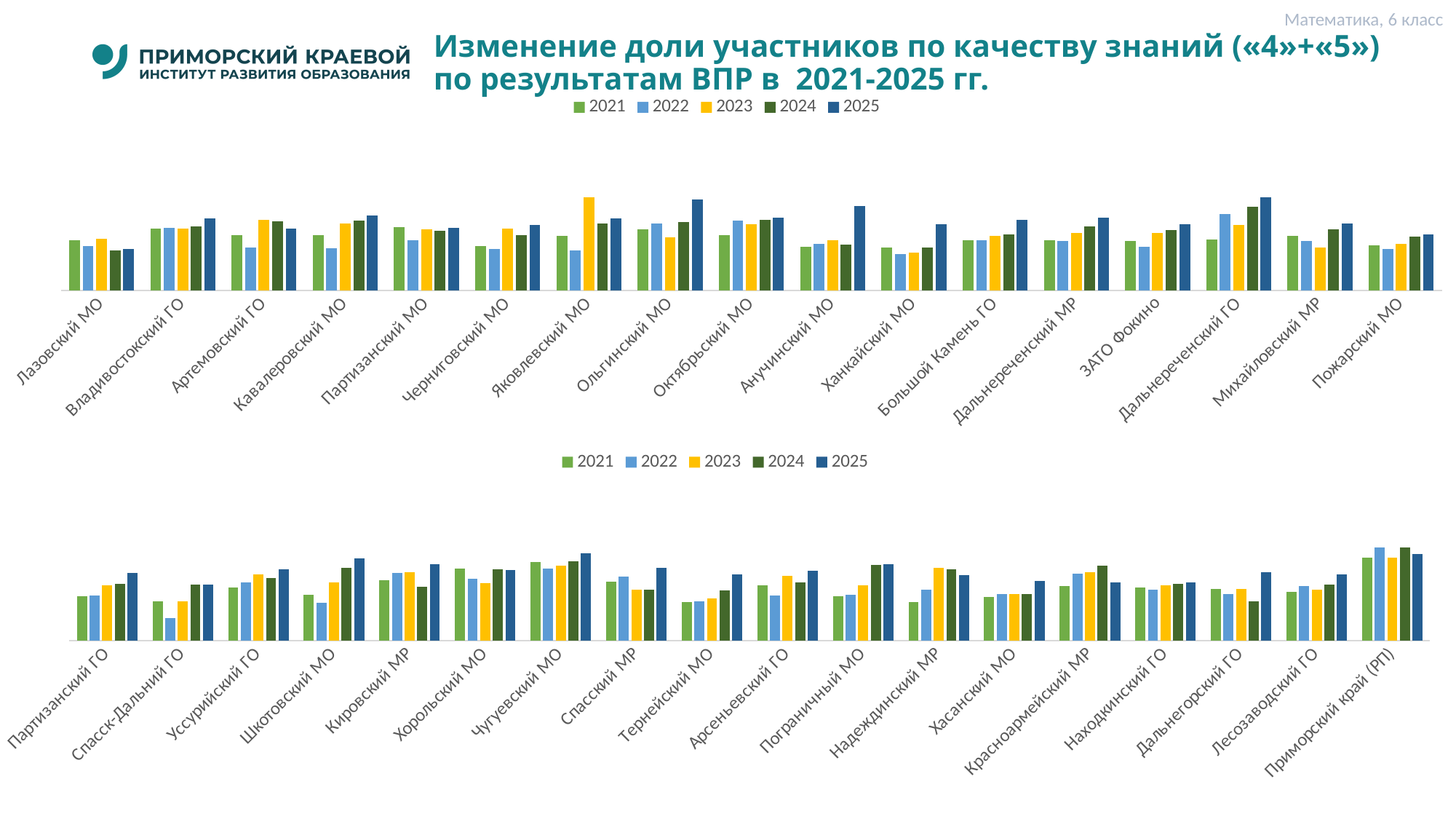
How many categories (municipalities) are shown on the top chart? 17 On the bottom chart, which year has the lowest bar for Спасск-Дальний ГО? 2022 What colour represents the 2023 series in the charts? Yellow What kind of chart is used on this slide? Bar chart Which years are listed in the legend of the charts? 2021, 2022, 2023, 2024, 2025 How many categories are shown on the bottom chart? 18 On the bottom chart, for Приморский край (РП), which is larger: the 2022 value or the 2023 value? 2022 How many series does the legend of the top chart list? 5 On the top chart, which year has the highest bar for Ханкайский МО? 2025 On the bottom chart, which year has the lowest bar for Дальнегорский ГО? 2024 On the top chart, which year has the highest bar for Яковлевский МО? 2023 On the bottom chart, do the values for Партизанский ГО overall rise or fall from 2021 to 2025? Rise